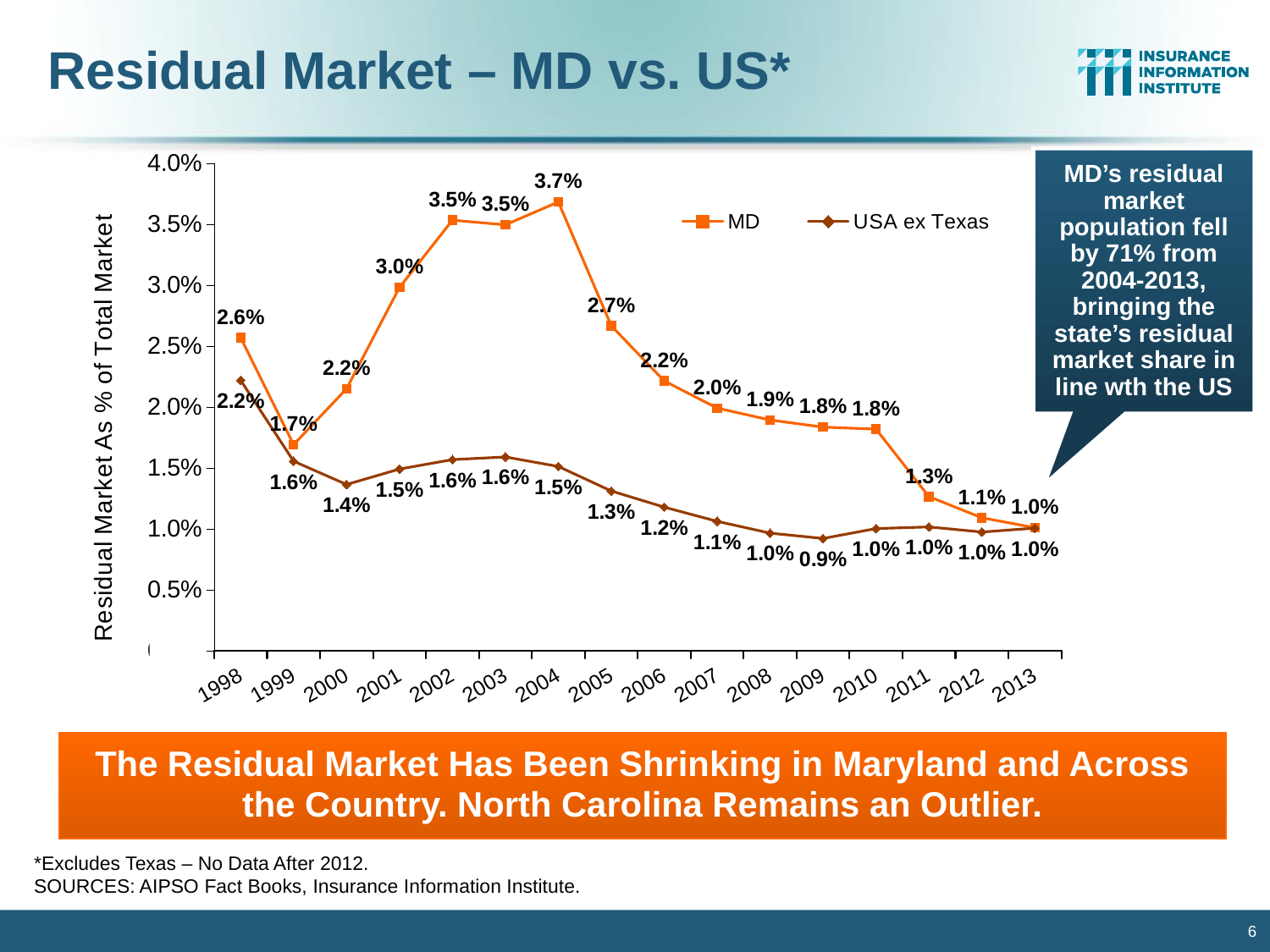
In which year was the USA ex Texas series at its lowest value? 2009 What was the USA ex Texas residual market share in 2009? 0.9% Did the MD series rise or fall from 2004 to 2013? Fall What was the MD residual market share in 2004? 3.7% How many series does the legend list? 2 In which year did the MD series reach its highest value? 2004 Which series had the higher value in 2005, MD or USA ex Texas? MD What is the difference between the MD and USA ex Texas values in 2004? 2.2% What was the MD value in 1998? 2.6% Is the MD value for 2001 greater or less than 2.5%? greater How many years are shown on the x axis? 16 What kind of chart is shown on the slide? Line chart